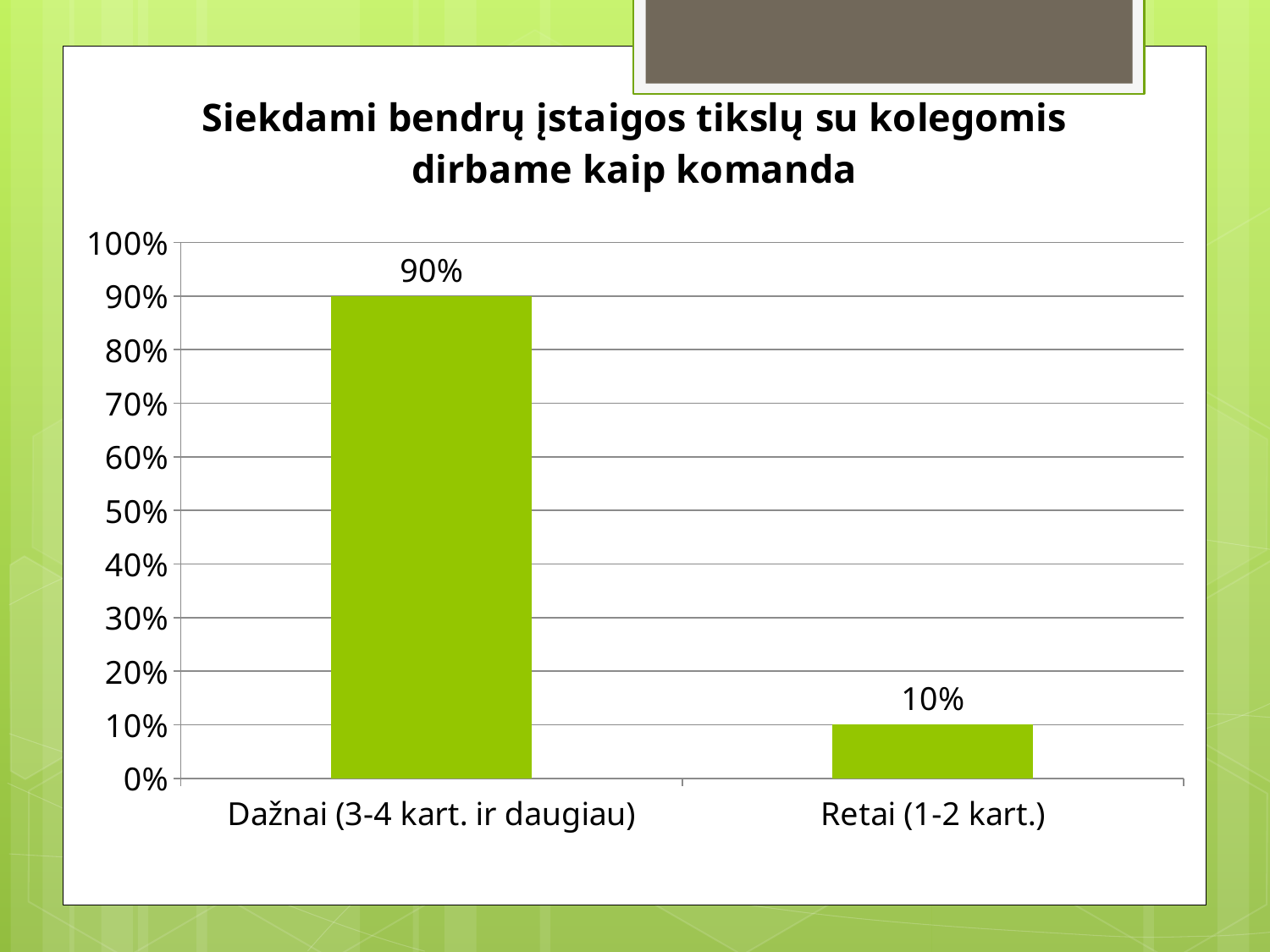
What is the value for "Retai (1-2 kart.)"? 10% What is the difference between the values for "Dažnai (3-4 kart. ir daugiau)" and "Retai (1-2 kart.)"? 80% What kind of chart is shown on the slide? bar chart What is the value for "Dažnai (3-4 kart. ir daugiau)"? 90% Which category has the highest value? Dažnai (3-4 kart. ir daugiau) Which is larger, the value for "Dažnai (3-4 kart. ir daugiau)" or the value for "Retai (1-2 kart.)"? Dažnai (3-4 kart. ir daugiau) Which category has the lowest value? Retai (1-2 kart.) What is the title of the chart? Siekdami bendrų įstaigos tikslų su kolegomis dirbame kaip komanda What is the maximum value shown on the y axis? 100% Is the value for "Dažnai (3-4 kart. ir daugiau)" greater or less than 50%? greater How many categories are shown on the x axis? 2 Is the value for "Retai (1-2 kart.)" greater or less than 20%? less